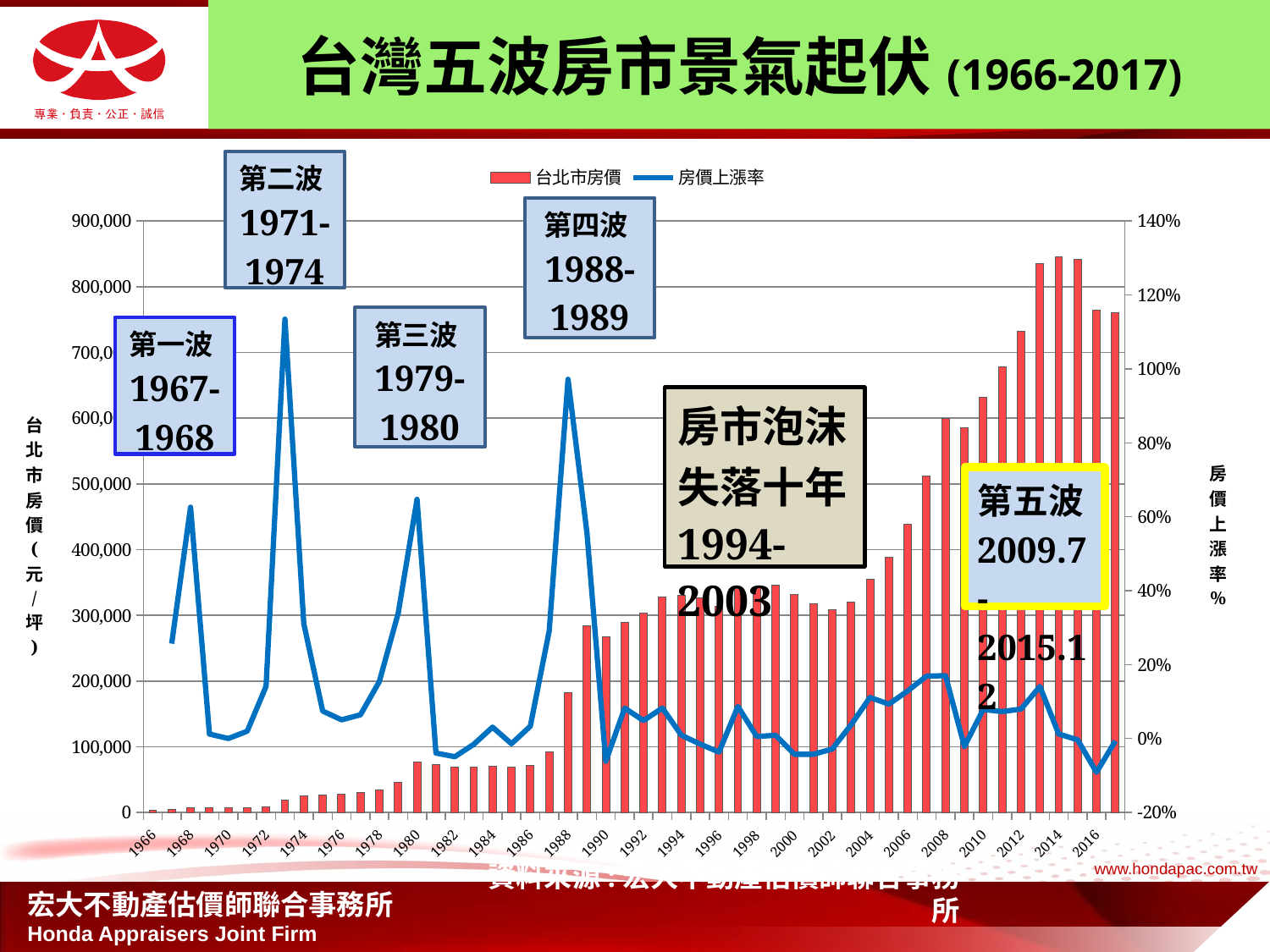
What kind of chart is shown on the slide? A combined bar and line chart Do the 台北市房價 bars generally rise or fall from 2003 to 2014? rise In which year does the 房價上漲率 line reach its highest value? 1973 Is the 台北市房價 bar for 2012 greater or less than 700,000? greater Is the 房價上漲率 value for 1973 greater or less than 100%? greater Which series is drawn as bars in the chart? 台北市房價 Is the 房價上漲率 value for 1988 greater or less than 80%? greater How many series does the legend list? 2 Which series is drawn as a line in the chart? 房價上漲率 Which is larger, the 房價上漲率 value for 1973 or for 1979? 1973